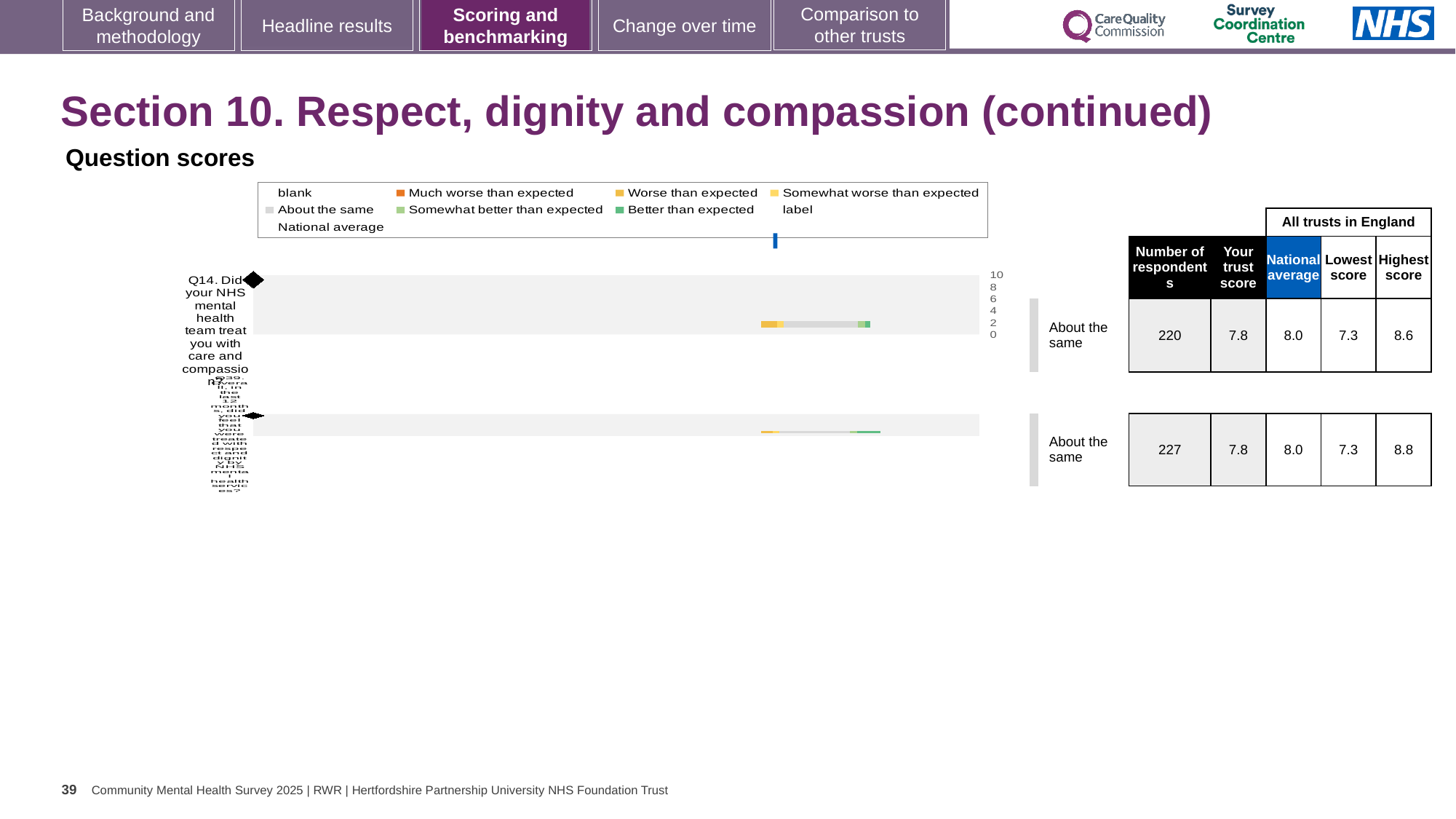
Which legend entry is shown in orange in the question scores chart? Much worse than expected What is the highest score among all trusts in England for Q39? 8.8 What kind of chart is used to show the question scores on this slide? bar chart What benchmark category is shown for Q14's trust score? About the same What is the highest value shown on the chart's score axis? 10 What is the 'Your trust score' value for Q14 (Did your NHS mental health team treat you with care and compassion?)? 7.8 What is the lowest score among all trusts in England for Q14? 7.3 What is the difference between the highest score and the lowest score for Q39? 1.5 What is the national average score for Q14? 8.0 How many survey questions are plotted in the question scores chart? 2 Which question has the larger highest score across all trusts in England, Q14 or Q39? Q39 How many respondents answered Q39? 227